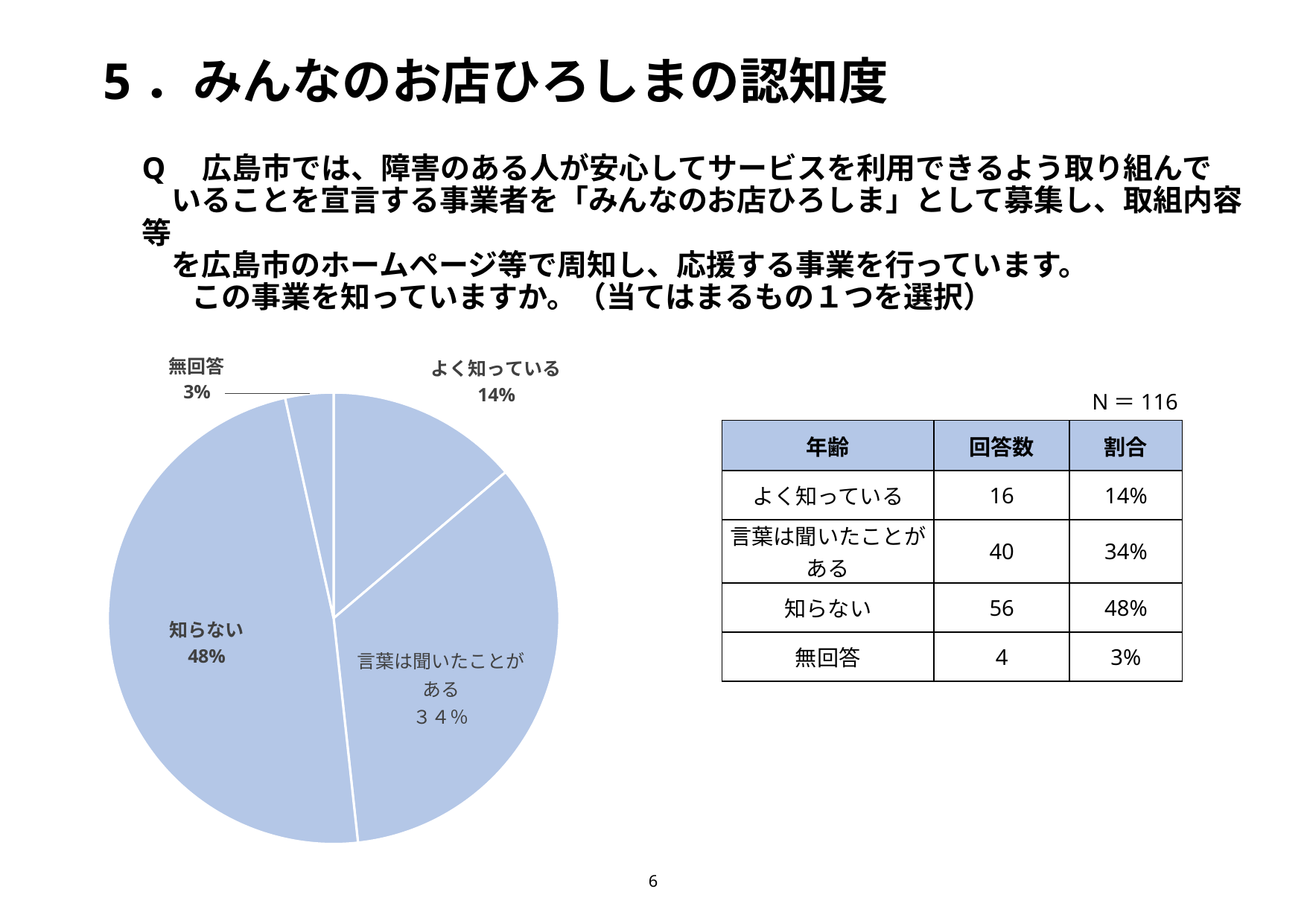
What share of the pie does 知らない take? 48% What is the total number of respondents (N) shown next to the table on the slide? 116 What is the difference in percentage points between 知らない and 言葉は聞いたことがある in the pie chart? 14 How many slices does the pie chart have? 4 Which slice of the pie chart is the smallest? 無回答 What share of the pie does よく知っている take? 14% What kind of chart is shown on the slide? pie chart What is the difference in percentage points between よく知っている and 無回答 in the pie chart? 11 What share of the pie does 言葉は聞いたことがある take? 34% Which is larger in the pie chart, よく知っている or 言葉は聞いたことがある? 言葉は聞いたことがある Which slice of the pie chart is the largest? 知らない